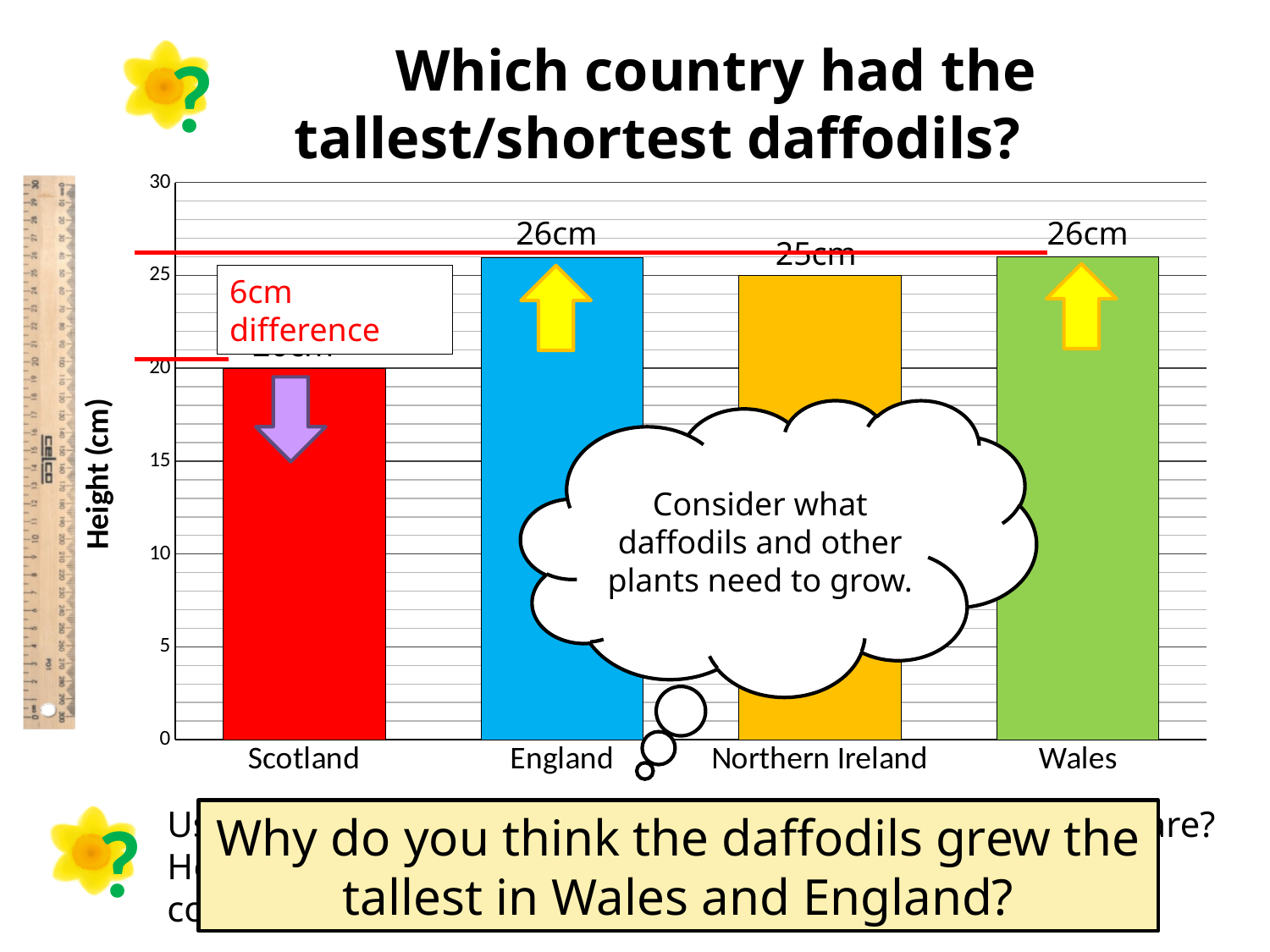
What is the difference in daffodil height between Scotland and the tallest daffodils? 6cm What is the difference in daffodil height between England and Northern Ireland? 1cm Which country had the shortest daffodils? Scotland Is the value for Scotland greater or less than 25? less What is the label on the vertical axis of the chart? Height (cm) Which has taller daffodils, Northern Ireland or Scotland? Northern Ireland What is the daffodil height shown for Wales? 26cm What is the daffodil height shown for England? 26cm What is the daffodil height shown for Northern Ireland? 25cm How many countries are shown on the chart? 4 What kind of chart is shown on the slide? Bar chart Which countries had the tallest daffodils? England and Wales